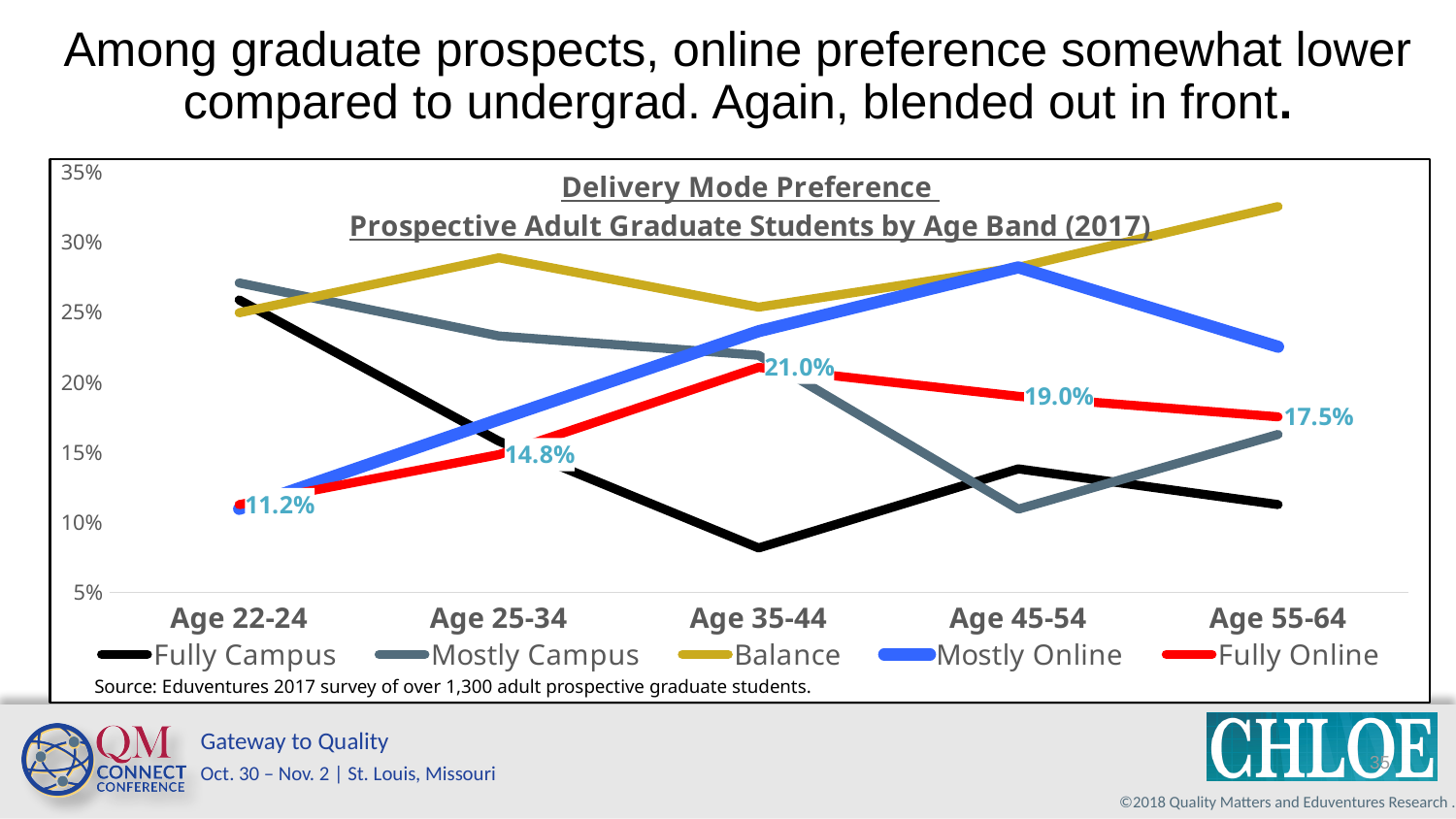
For the Fully Online series, which age band has the highest value? Age 35-44 How many series does the legend list? 5 Is the Balance value for Age 55-64 greater or less than 30%? greater Which is larger for Fully Online: the value for Age 25-34 or the value for Age 45-54? Age 45-54 For the Fully Online series, which age band has the lowest value? Age 22-24 What is the difference between the Fully Online values for Age 35-44 and Age 22-24? 9.8 percentage points What type of chart is shown on the slide? Line chart How many age bands are shown on the x axis? 5 What is the Fully Online value for Age 22-24? 11.2% What is the Fully Online value for Age 35-44? 21.0% Does the Fully Online series rise or fall from Age 35-44 to Age 55-64? Fall What is the Fully Online value for Age 55-64? 17.5%